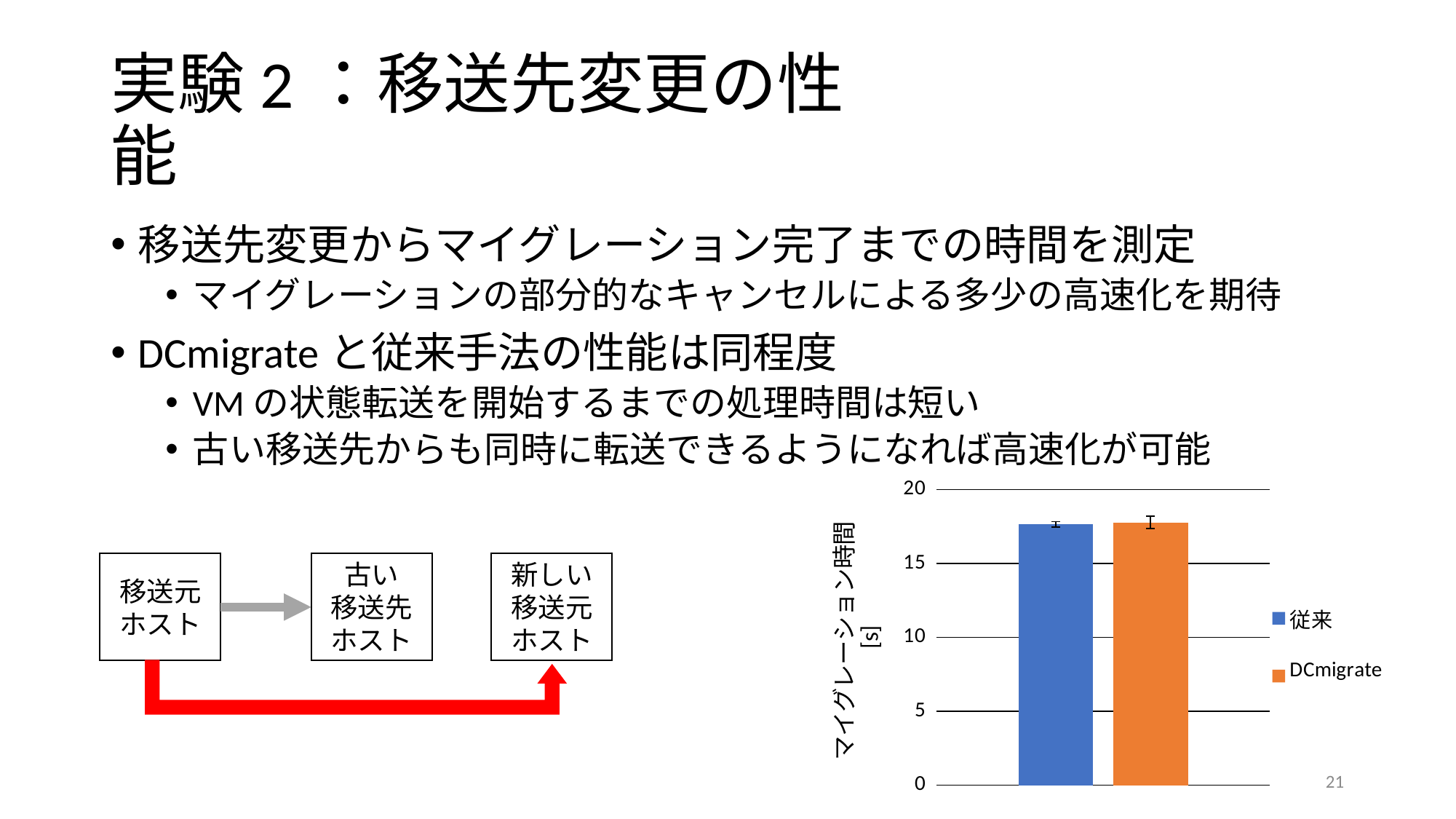
Which series is shown in orange in the chart? DCmigrate Is the value for DCmigrate greater or less than 15? greater What is the highest tick value shown on the vertical axis? 20 Is the value for DCmigrate greater or less than 20? less Is the value for 従来 greater or less than 15? greater How many bars are plotted in the chart? 2 What is the label of the vertical axis of the chart? マイグレーション時間 [s] How many series does the chart legend list? 2 What kind of chart is shown on the slide? bar chart